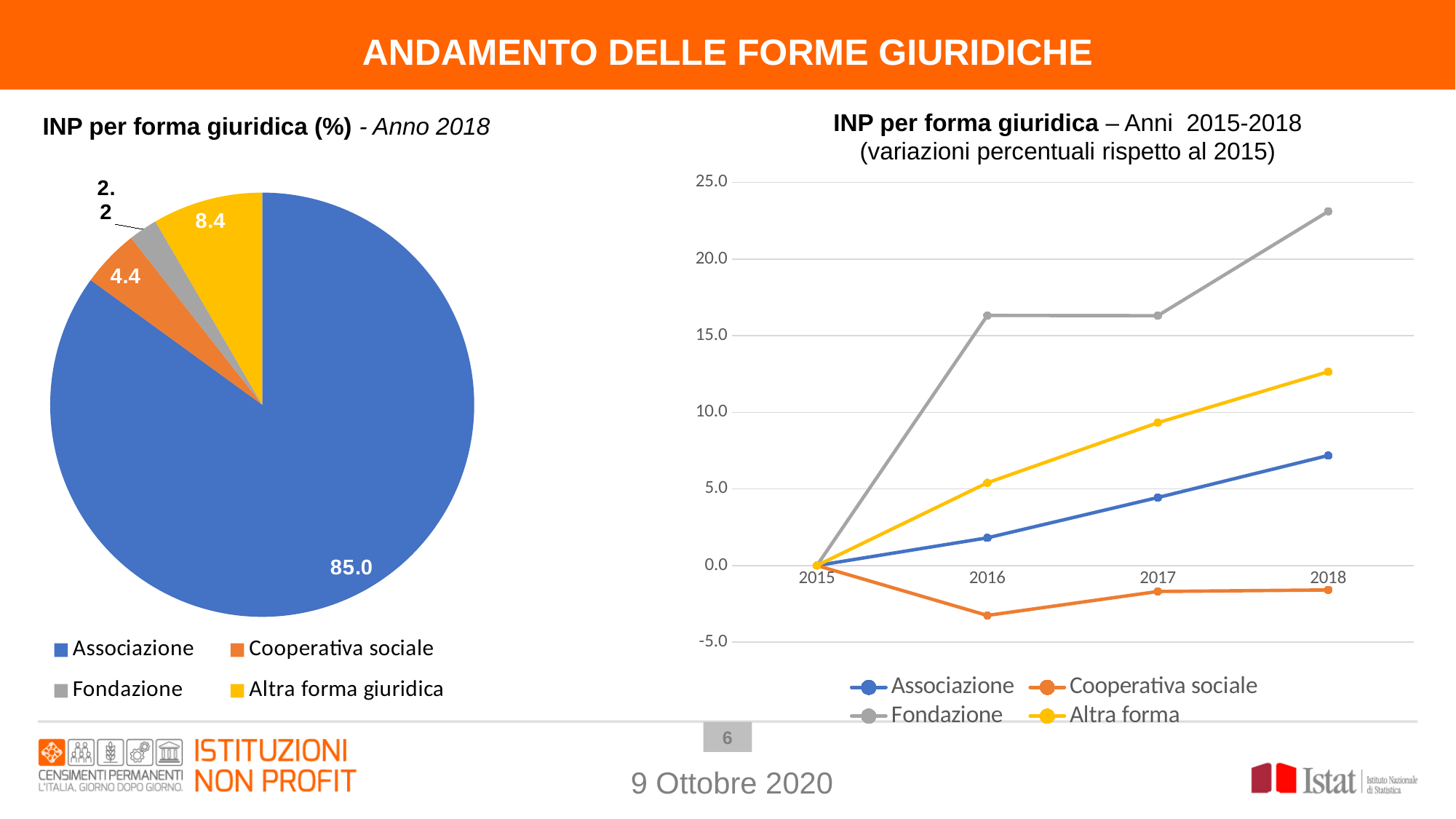
In the pie chart 'INP per forma giuridica (%) - Anno 2018', which legal form has the smallest slice? Fondazione In the pie chart 'INP per forma giuridica (%) - Anno 2018', what is the value for Associazione? 85.0 In the pie chart 'INP per forma giuridica (%) - Anno 2018', which legal form has the largest slice? Associazione In the pie chart 'INP per forma giuridica (%) - Anno 2018', what is the value for Altra forma giuridica? 8.4 What kind of chart is the chart on the right, 'INP per forma giuridica – Anni 2015-2018'? line chart In the line chart 'INP per forma giuridica – Anni 2015-2018', is the value for Cooperativa sociale in 2016 greater or less than 0.0? less In the line chart 'INP per forma giuridica – Anni 2015-2018', which series has the highest value in 2018? Fondazione In the line chart 'INP per forma giuridica – Anni 2015-2018', how many series does the legend list? 4 In the pie chart 'INP per forma giuridica (%) - Anno 2018', what is the value for Cooperativa sociale? 4.4 In the pie chart 'INP per forma giuridica (%) - Anno 2018', what is the difference between the values for Altra forma giuridica and Cooperativa sociale? 4.0 In the pie chart 'INP per forma giuridica (%) - Anno 2018', how many legal forms are shown? 4 In the line chart 'INP per forma giuridica – Anni 2015-2018', is the value for Fondazione in 2018 greater or less than 20.0? greater